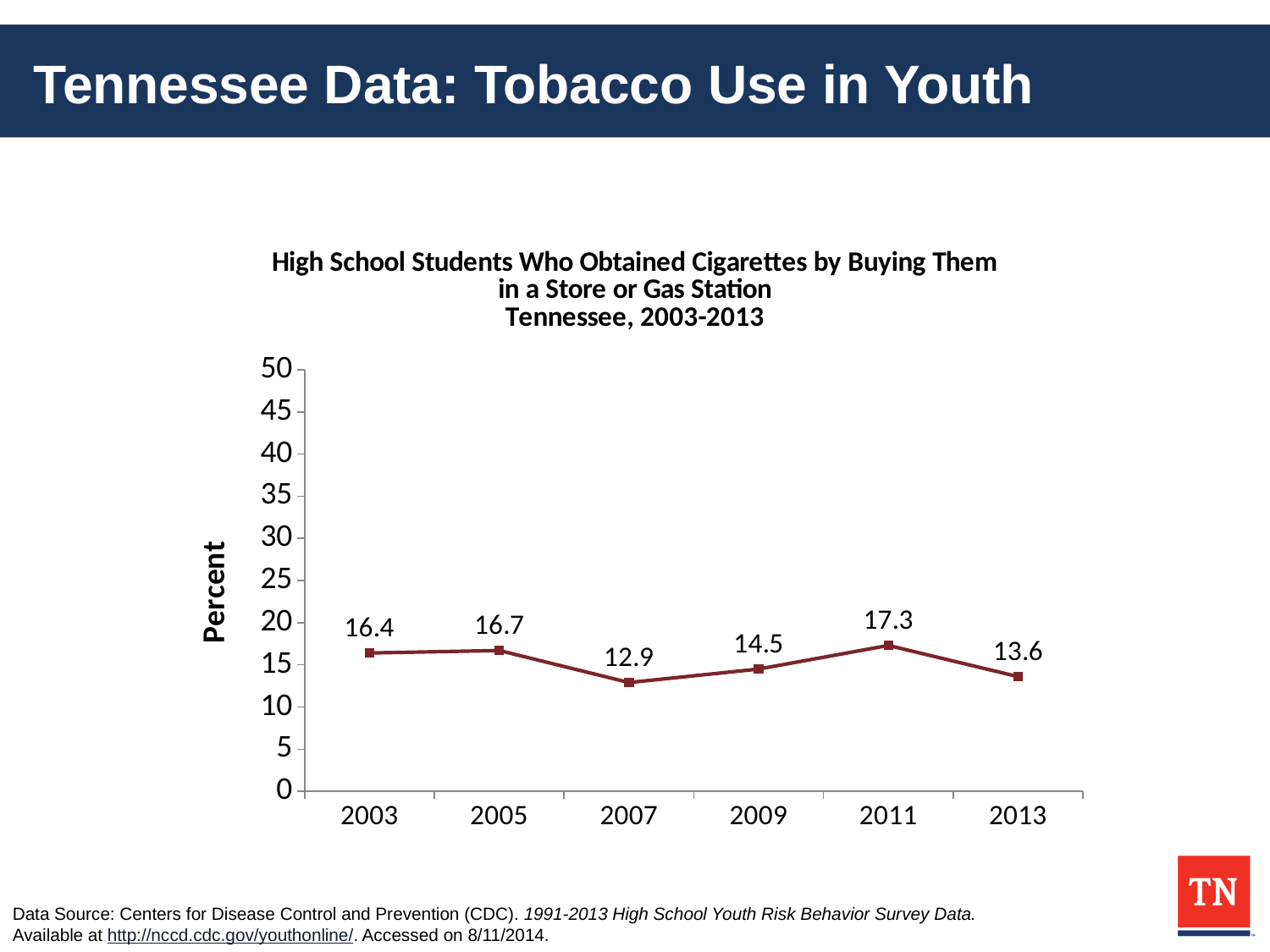
What is the value for 2003? 16.4 How many years are plotted on the x axis? 6 Which year has the lowest value? 2007 Which is larger, the value for 2005 or the value for 2009? 2005 What is the value for 2013? 13.6 What is the label of the y axis? Percent Is the value for 2011 greater or less than 20? less What is the difference between the values for 2011 and 2007? 4.4 What kind of chart is shown? line chart Which year has the highest value? 2011 Does the value rise or fall from 2011 to 2013? fall What is the value for 2007? 12.9